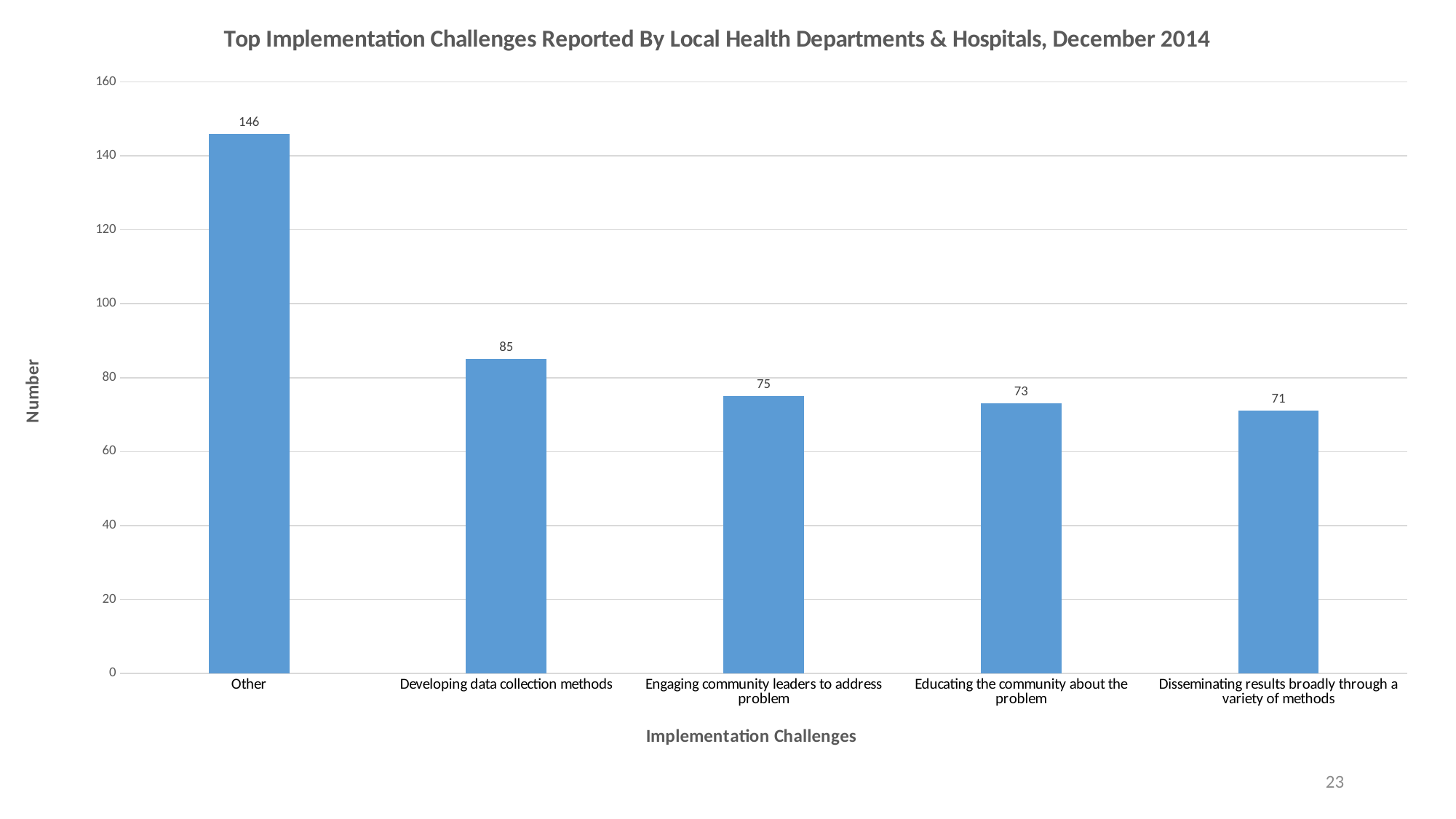
What is the value for "Other"? 146 Which category has the lowest value? Disseminating results broadly through a variety of methods What is the value for "Disseminating results broadly through a variety of methods"? 71 How many categories are shown on the chart? 5 What is the title of the chart? Top Implementation Challenges Reported By Local Health Departments & Hospitals, December 2014 What is the value for "Engaging community leaders to address problem"? 75 What is the difference between the values for "Other" and "Developing data collection methods"? 61 Which is larger, the value for "Engaging community leaders to address problem" or "Educating the community about the problem"? Engaging community leaders to address problem Which category has the highest value? Other What is the value for "Developing data collection methods"? 85 What is the label of the vertical axis? Number What kind of chart is shown on the slide? Bar chart